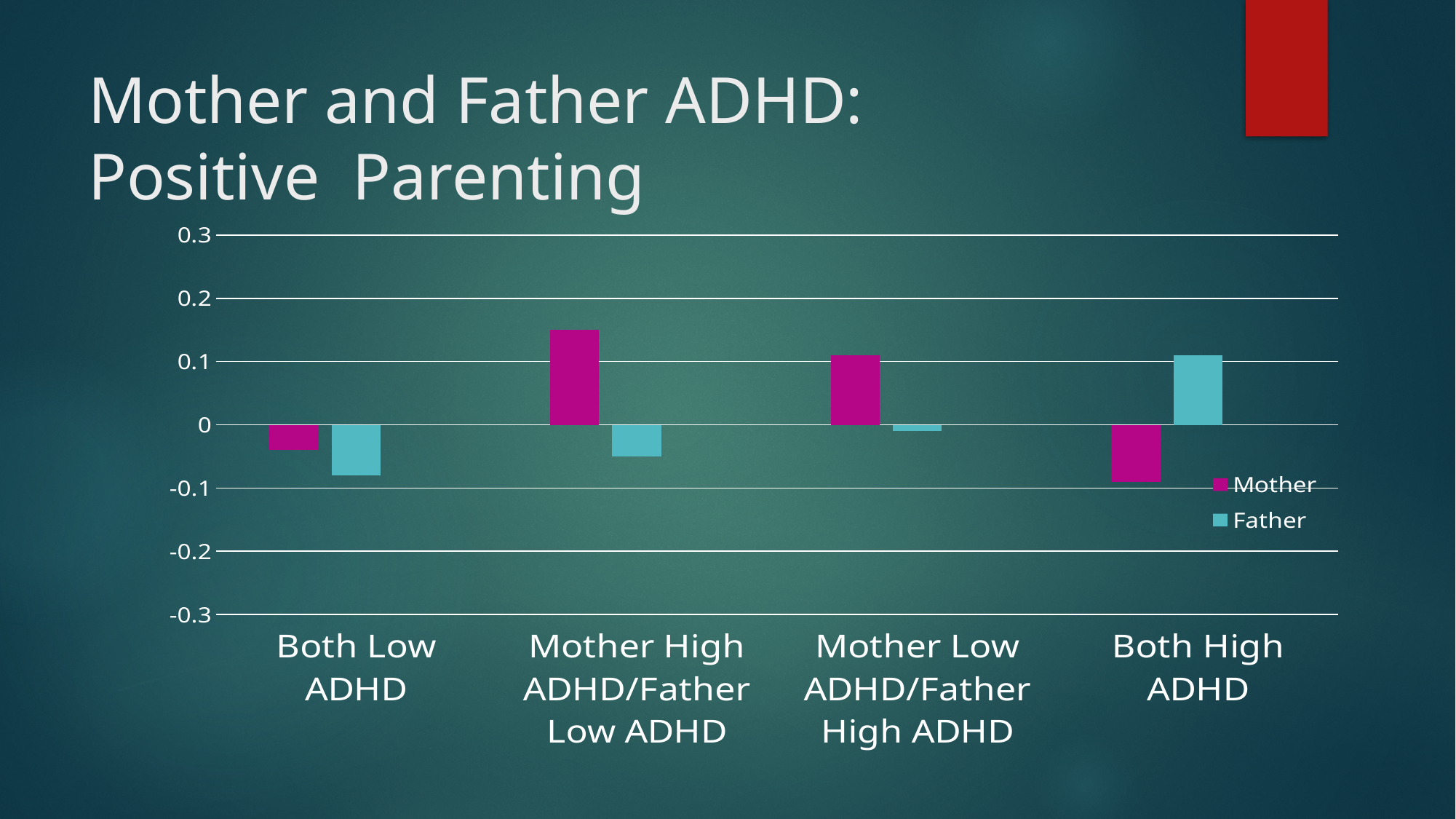
Which category has the lowest Father value? Both Low ADHD How many categories are shown on the x axis? 4 Which category has the highest Father value? Both High ADHD What colour are the Mother bars? magenta For Both High ADHD, which is larger, the Mother value or the Father value? Father Which category has the lowest Mother value? Both High ADHD Is the Mother value for Mother High ADHD/Father Low ADHD greater or less than 0.1? greater What kind of chart is shown on the slide? bar chart How many series does the legend list? 2 Is the Mother value for Both High ADHD greater or less than 0? less Which category has the highest Mother value? Mother High ADHD/Father Low ADHD Is the Father value for Both Low ADHD greater or less than 0? less